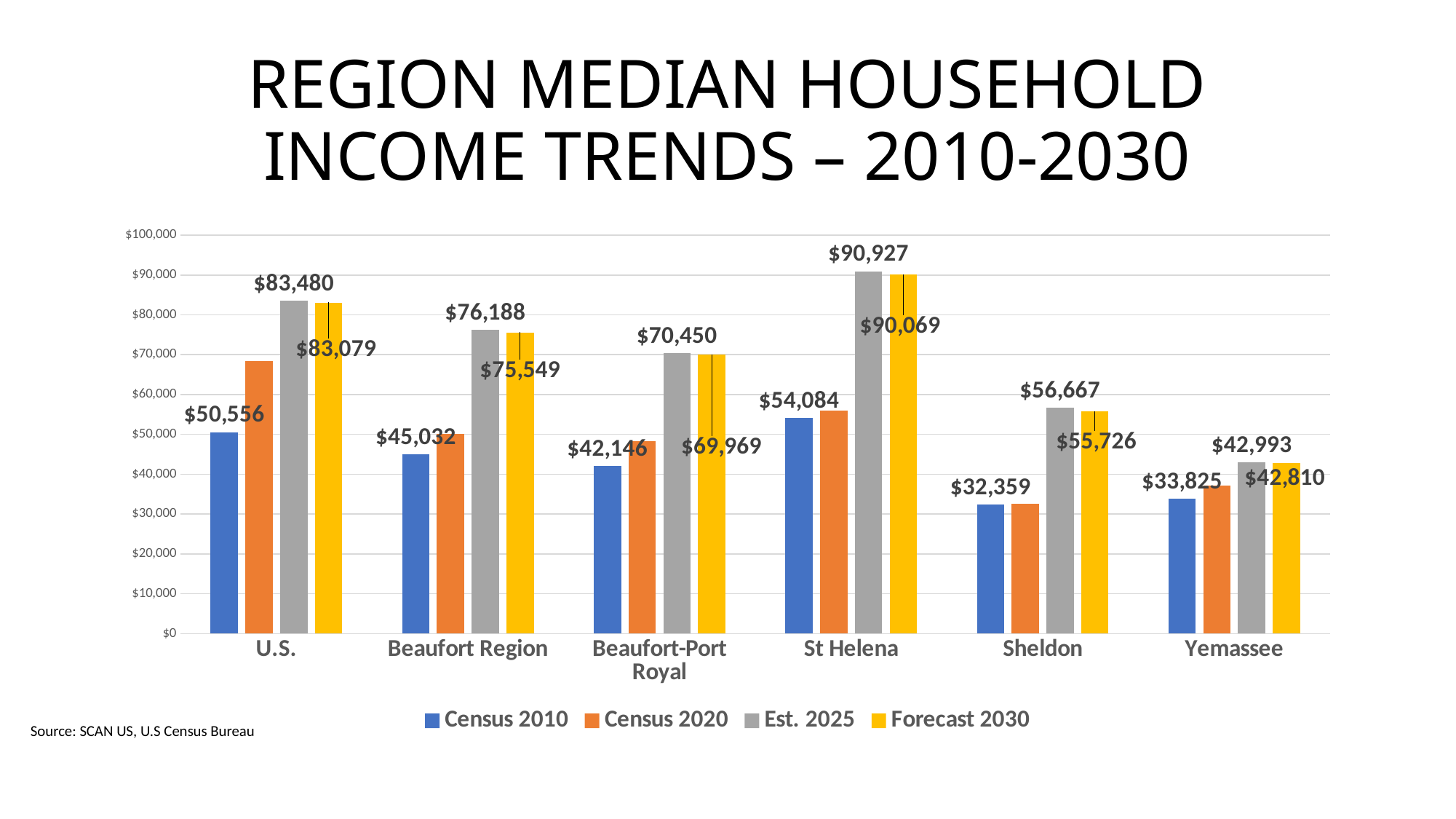
What is the Forecast 2030 value for Sheldon? $55,726 Which has the larger Census 2010 value, Beaufort Region or Beaufort-Port Royal? Beaufort Region What kind of chart is shown on the slide? bar chart What is the difference between the Est. 2025 and Forecast 2030 values for the U.S.? $401 What is the difference between the Est. 2025 and Forecast 2030 values for St Helena? $858 Is the Census 2020 value for the U.S. greater or less than $60,000? greater Which category has the lowest Census 2010 value? Sheldon How many categories are shown on the x axis? 6 How many series does the legend list? 4 What is the Census 2010 median household income for the U.S.? $50,556 What is the Est. 2025 value for St Helena? $90,927 Which category has the highest Est. 2025 value? St Helena